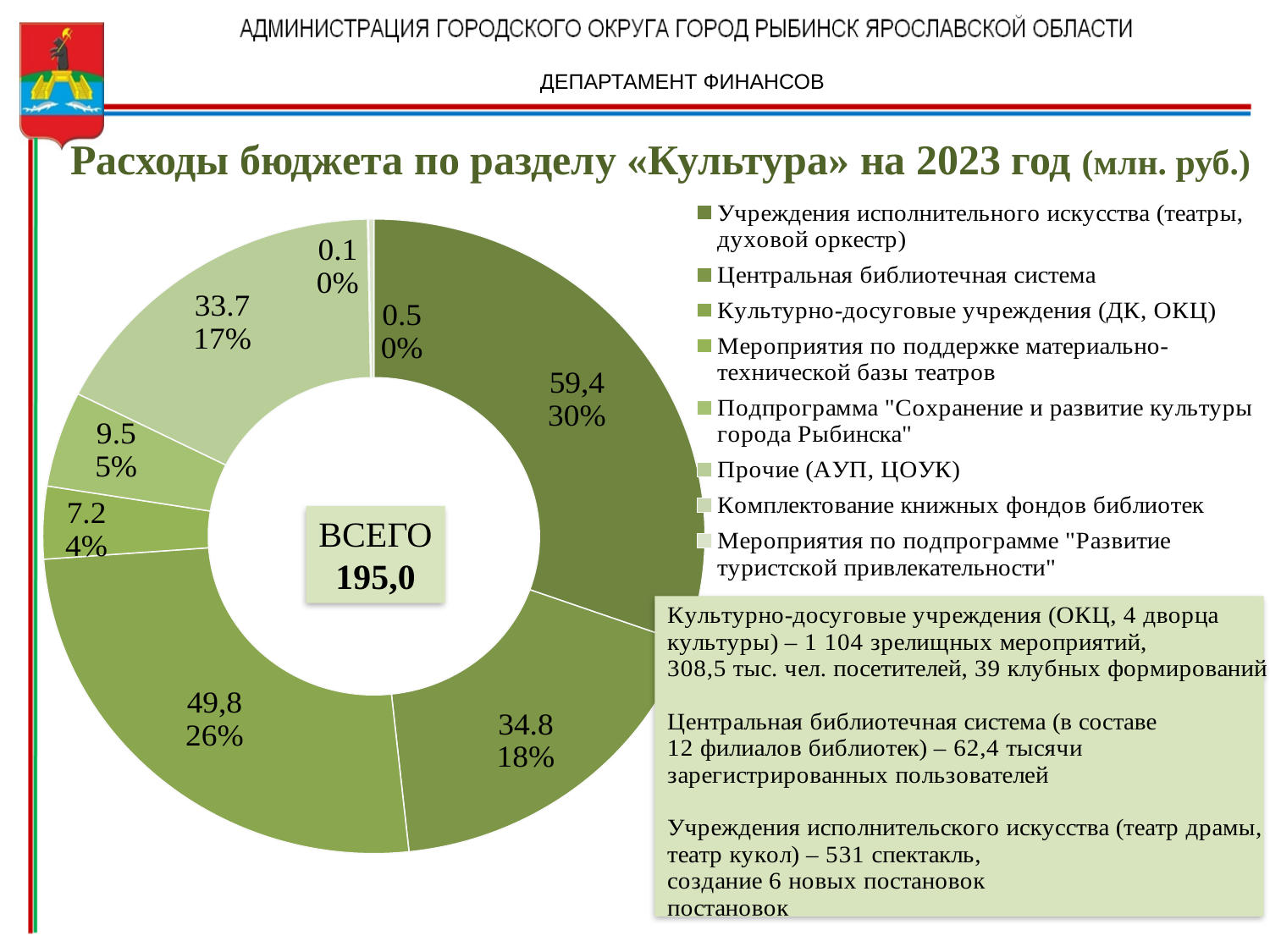
Which slice of the chart is the smallest? 0.1 (0%) Which slice of the chart is the largest? Учреждения исполнительного искусства (театры, духовой оркестр) – 59,4 (30%) What value is shown for Учреждения исполнительного искусства (театры, духовой оркестр)? 59,4 What is the title of the chart on the slide? Расходы бюджета по разделу «Культура» на 2023 год (млн. руб.) How many entries does the legend list? 8 What kind of chart is shown on the slide? Doughnut (pie) chart What value is shown for Центральная библиотечная система? 34.8 What percentage is shown for the slice with value 33.7? 17% Which is larger: the slice with value 9.5 or the slice with value 7.2? 9.5 What share of the chart does the slice labelled 49,8 represent? 26% How many slices does the doughnut chart have? 8 What total value is shown in the centre of the doughnut chart? 195,0